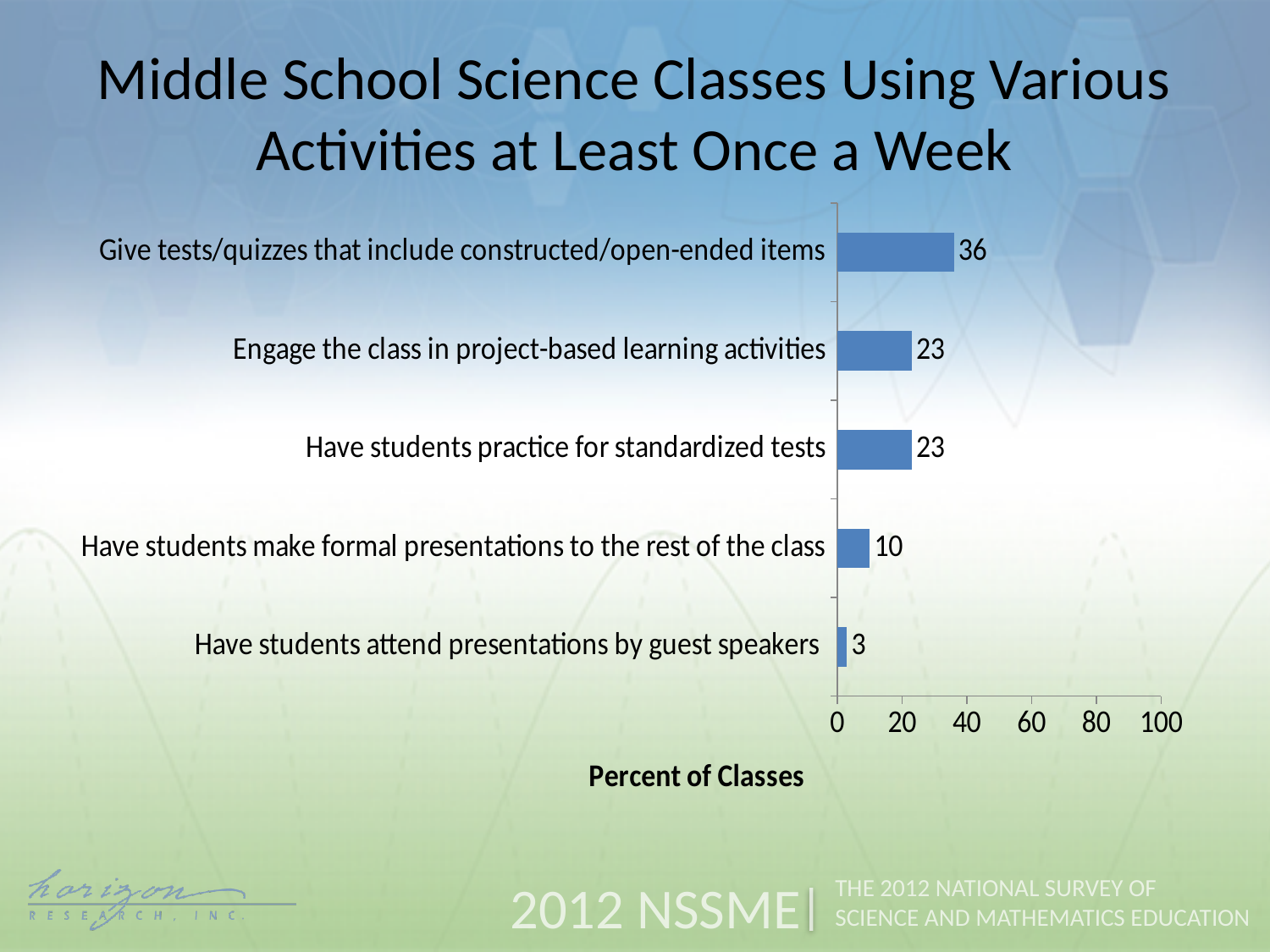
What kind of chart is shown on the slide? Bar chart What is the value for 'Have students attend presentations by guest speakers'? 3 Which activity has the lowest percent of classes? Have students attend presentations by guest speakers What is the label of the horizontal axis? Percent of Classes Is the value for 'Give tests/quizzes that include constructed/open-ended items' greater or less than 40? less What is the difference between the value for giving tests/quizzes with constructed/open-ended items and the value for having students practice for standardized tests? 13 Which is larger: the value for having students make formal presentations or the value for having students attend presentations by guest speakers? Have students make formal presentations to the rest of the class What percent of classes give tests/quizzes that include constructed/open-ended items at least once a week? 36 Which activity has the highest percent of classes? Give tests/quizzes that include constructed/open-ended items What is the value for 'Have students make formal presentations to the rest of the class'? 10 What is the value for 'Engage the class in project-based learning activities'? 23 How many activities are shown in the chart? 5